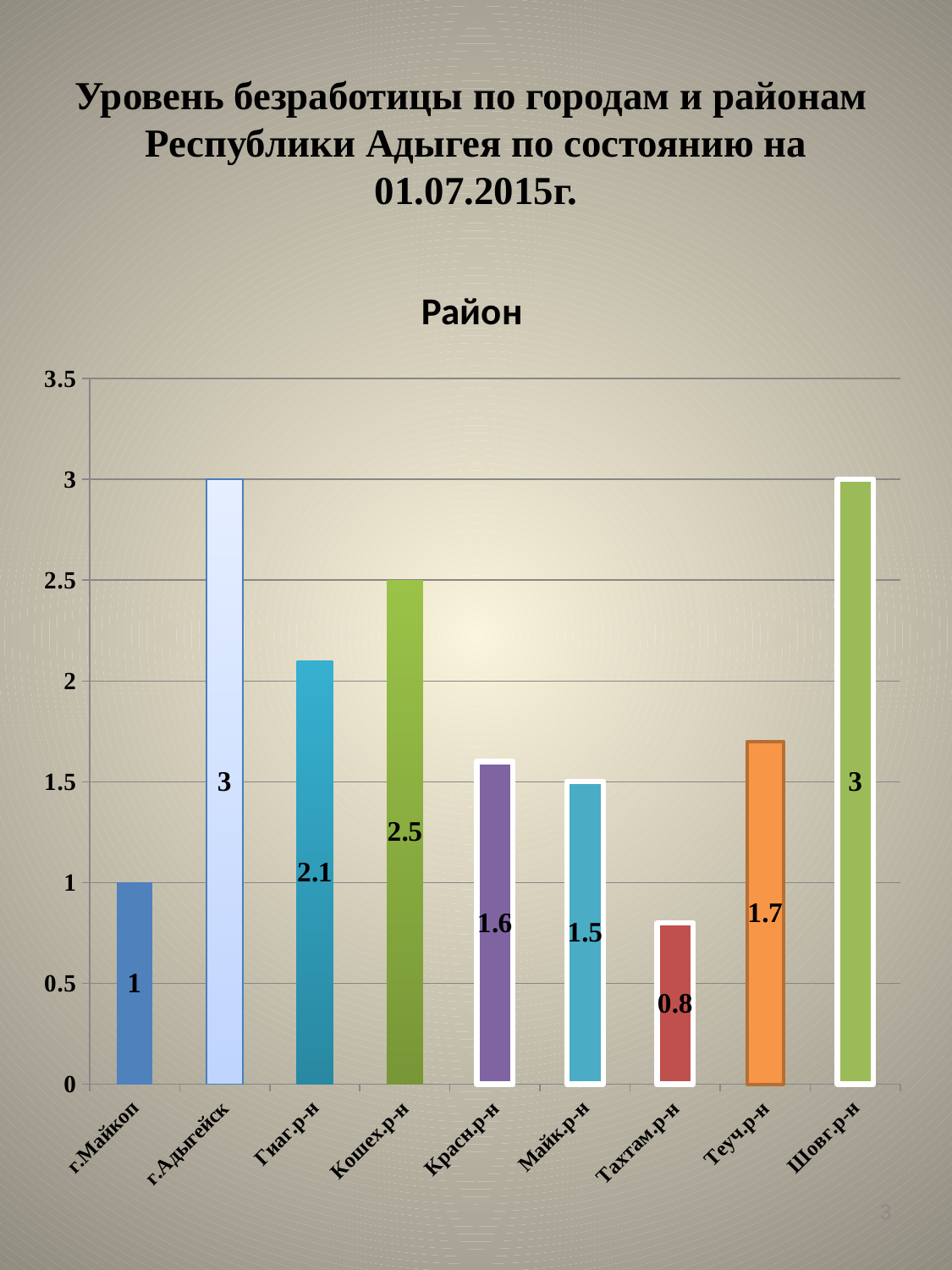
What is the value for Теуч.р-н? 1.7 What is the difference between the values for Гиаг.р-н and Майк.р-н? 0.6 How many categories are shown on the x axis? 9 Which category has the lowest value? Тахтам.р-н Which is larger, the value for Красн.р-н or the value for Теуч.р-н? Теуч.р-н Is the value for Кошех.р-н greater or less than 2? greater What is the value for Тахтам.р-н? 0.8 What is the value for Кошех.р-н? 2.5 What is the value for г.Майкоп? 1 What is the title of the chart? Район What is the difference between the values for г.Адыгейск and г.Майкоп? 2 What kind of chart is shown on the slide? bar chart